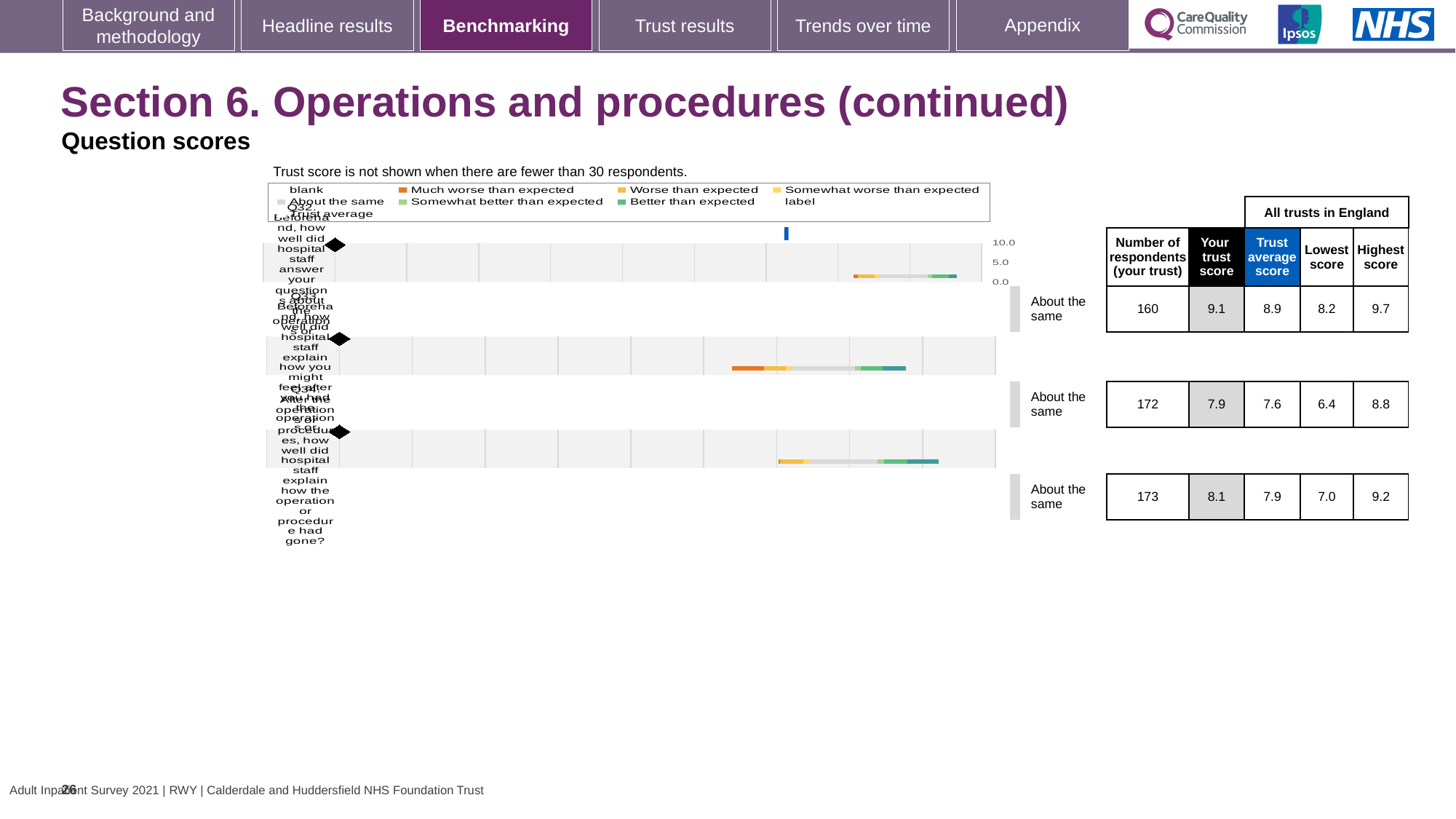
Which of the three questions has the highest 'Your trust score'? Q32 For the first chart (Q32), what is the difference between your trust score and the trust average score? 0.2 For the third chart (Q34), what is the highest score across all trusts in England? 9.2 How many question charts are shown on the slide? 3 Which of the three questions has the lowest 'Lowest score' value in the table? Q33 For the second chart (Q33), which is larger: your trust score or the trust average score? Your trust score For the first chart (Q32), is your trust score greater or less than 5.0? greater For the first chart (Q32), what is the 'Your trust score' shown in the table? 9.1 For the second chart (Q33), how many respondents does the table show for your trust? 172 What is the maximum value shown on the score axis of the charts? 10.0 What benchmark rating is shown next to the third chart (Q34)? About the same What kind of chart is used for the question scores on this slide? bar chart